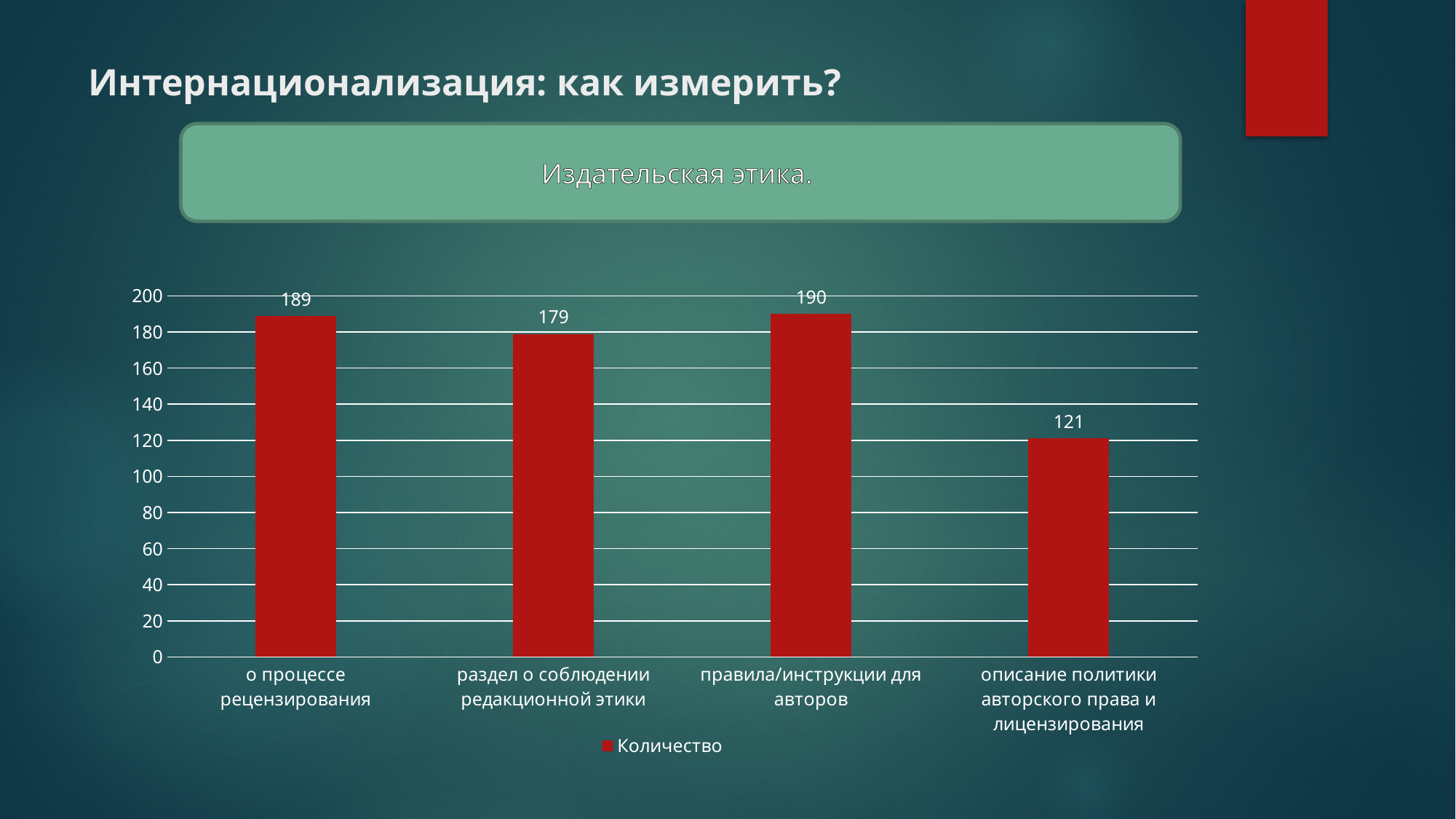
What is the value for "описание политики авторского права и лицензирования"? 121 What kind of chart is shown on the slide? bar chart Which is larger: the value for "раздел о соблюдении редакционной этики" or for "описание политики авторского права и лицензирования"? раздел о соблюдении редакционной этики How many categories are shown in the chart? 4 Is the value for "описание политики авторского права и лицензирования" greater or less than 140? less What is the value for "о процессе рецензирования"? 189 Which category has the lowest value? описание политики авторского права и лицензирования What is the difference between the values for "о процессе рецензирования" and "описание политики авторского права и лицензирования"? 68 How many series does the legend list? 1 Which category has the highest value? правила/инструкции для авторов What is the value for "раздел о соблюдении редакционной этики"? 179 What is the value for "правила/инструкции для авторов"? 190